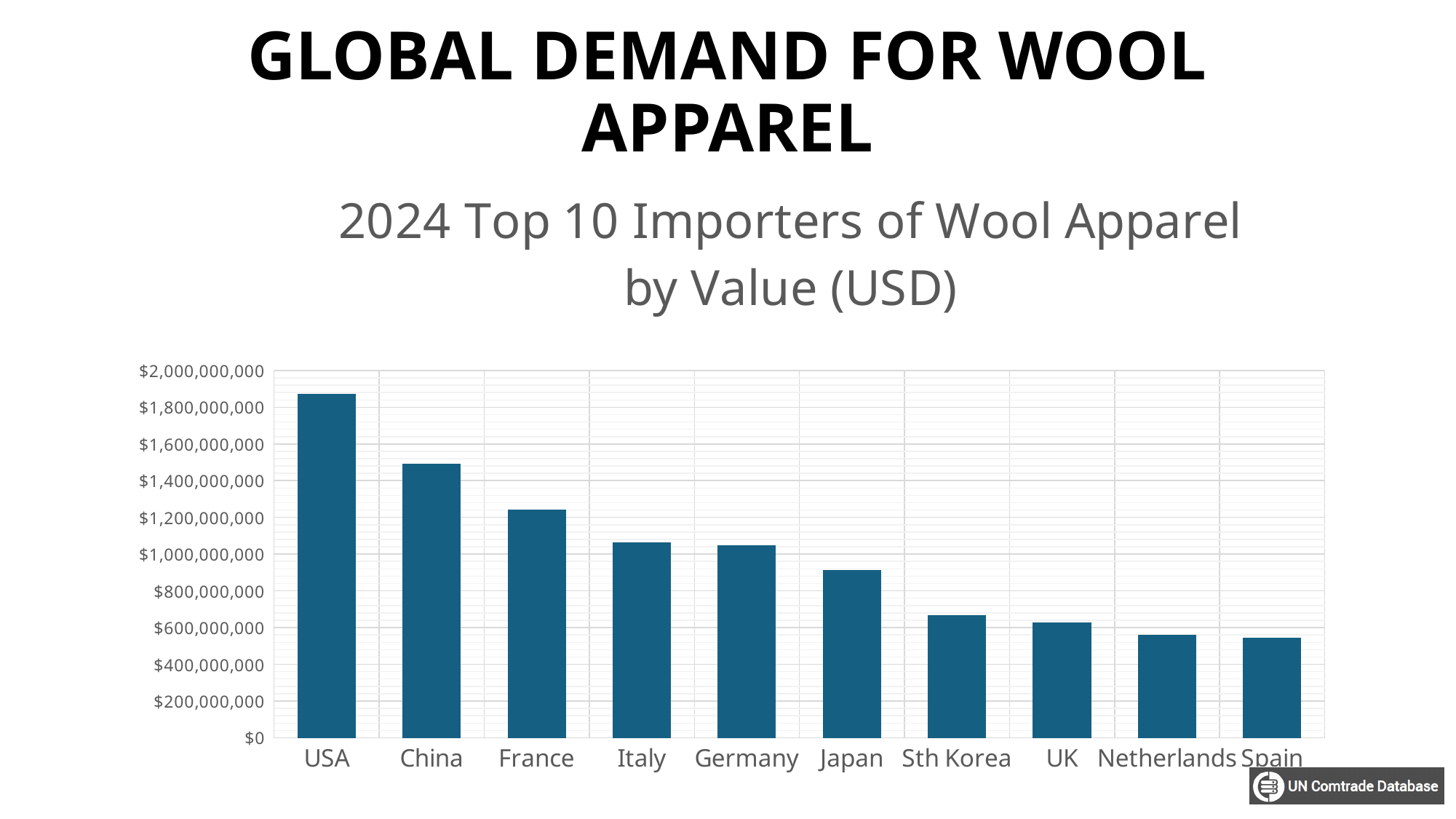
Is the value for Netherlands greater or less than $600,000,000? less Do the values rise or fall moving from left to right along the x axis? fall What kind of chart is shown on the slide? bar chart How many countries are shown in the chart? 10 Which country has the highest import value in the chart? USA Which country has the lowest import value in the chart? Spain Is the value for China greater or less than $1,600,000,000? less Which has a larger import value, China or France? China Is the value for France greater or less than $1,400,000,000? less What is the title of the chart? 2024 Top 10 Importers of Wool Apparel by Value (USD)